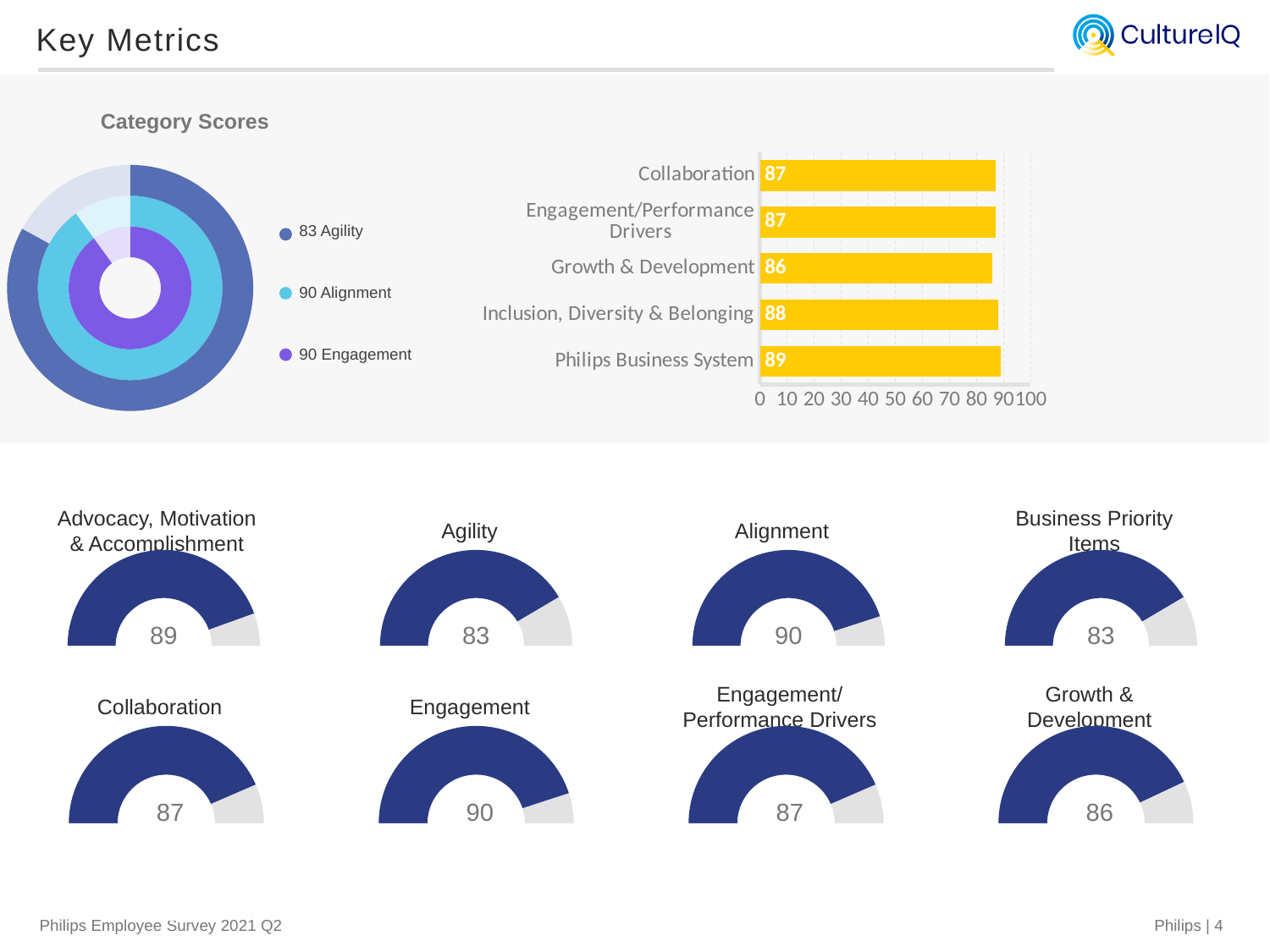
In the horizontal bar chart at the top right, which category has the lowest value? Growth & Development In the gauge chart titled Business Priority Items at the bottom of the slide, what value is shown? 83 In the Category Scores donut chart at the top left, what is the value for Agility? 83 In the horizontal bar chart at the top right, what is the value for Philips Business System? 89 In the horizontal bar chart at the top right, what is the difference between Philips Business System and Growth & Development? 3 What kind of chart is the yellow chart at the top right of the slide? Bar chart In the horizontal bar chart at the top right, what is the value for Inclusion, Diversity & Belonging? 88 Among the eight gauge charts at the bottom of the slide, which ones show the highest value? Alignment and Engagement In the Category Scores donut chart at the top left, how many entries does the legend list? 3 In the horizontal bar chart at the top right, which category has the highest value? Philips Business System In the Category Scores donut chart at the top left, is the value for Alignment larger or smaller than the value for Agility? Larger In the horizontal bar chart at the top right, how many categories are shown? 5